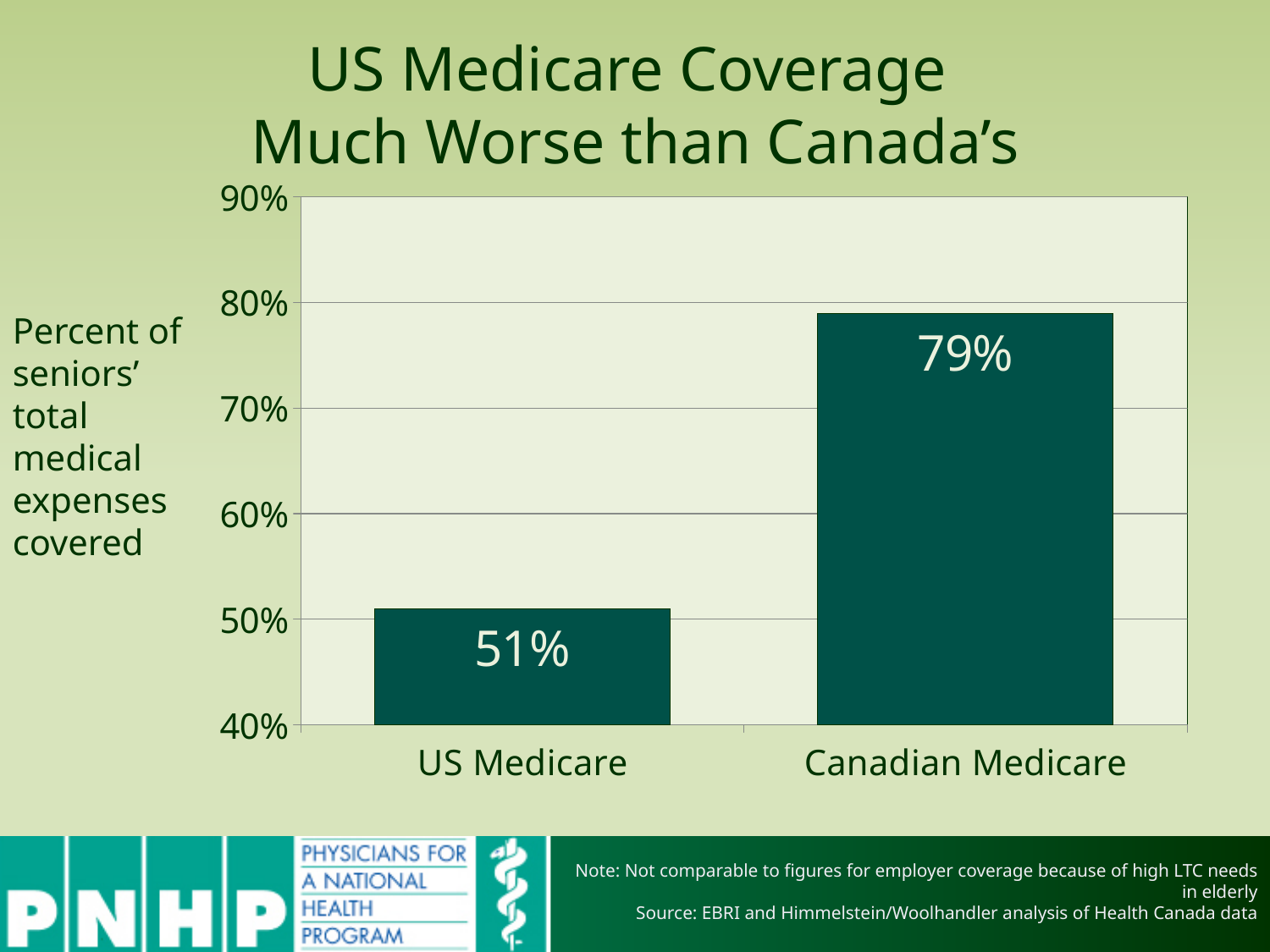
How many categories are shown on the chart? 2 What kind of chart is shown on the slide? bar chart Is the value for Canadian Medicare greater or less than 70%? greater What is the title of the slide? US Medicare Coverage Much Worse than Canada's Which category has the higher value, US Medicare or Canadian Medicare? Canadian Medicare Is the value for US Medicare larger or smaller than the value for Canadian Medicare? smaller What percent of seniors' total medical expenses does Canadian Medicare cover? 79% Is the value for US Medicare greater or less than 60%? less Which category has the lowest value on the chart? US Medicare What is the lowest value shown on the vertical axis? 40% What percent of seniors' total medical expenses does US Medicare cover? 51% What is the difference in percentage points between Canadian Medicare and US Medicare? 28